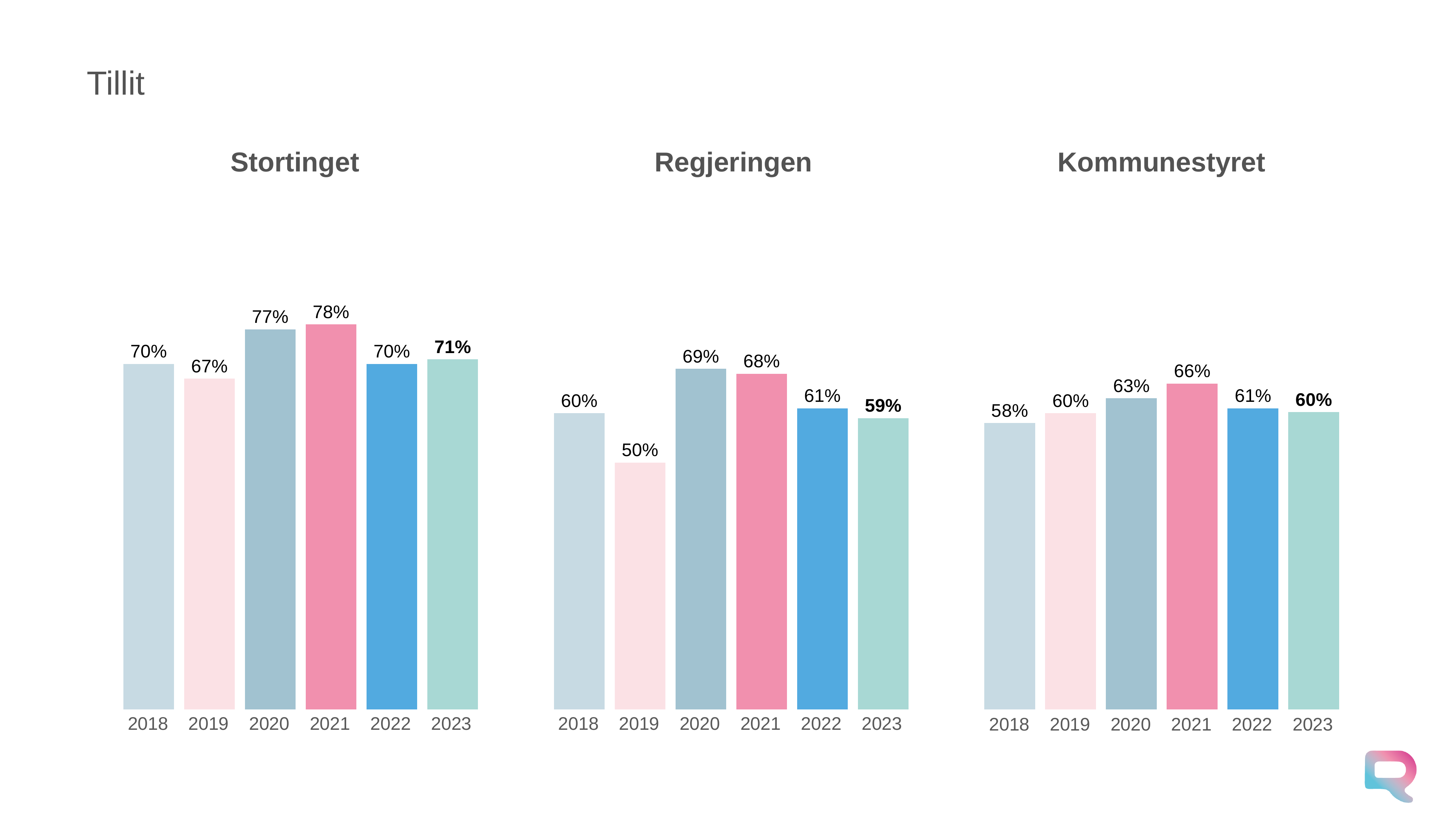
In the Stortinget chart, what is the value for 2021? 78% How many years are shown in the Regjeringen chart? 6 What is the title of the slide? Tillit In the Kommunestyret chart, which year has the highest value? 2021 In the Regjeringen chart, what is the value for 2019? 50% What kind of chart is the Stortinget chart? bar chart In the Regjeringen chart, what is the difference between the 2020 value and the 2019 value? 19% In the Stortinget chart, what is the difference between the 2021 value and the 2023 value? 7% In the Stortinget chart, which year has the lowest value? 2019 In the Kommunestyret chart, what is the value for 2023? 60% In the Kommunestyret chart, which is larger, the value for 2020 or the value for 2018? 2020 In the Regjeringen chart, which year has the highest value? 2020